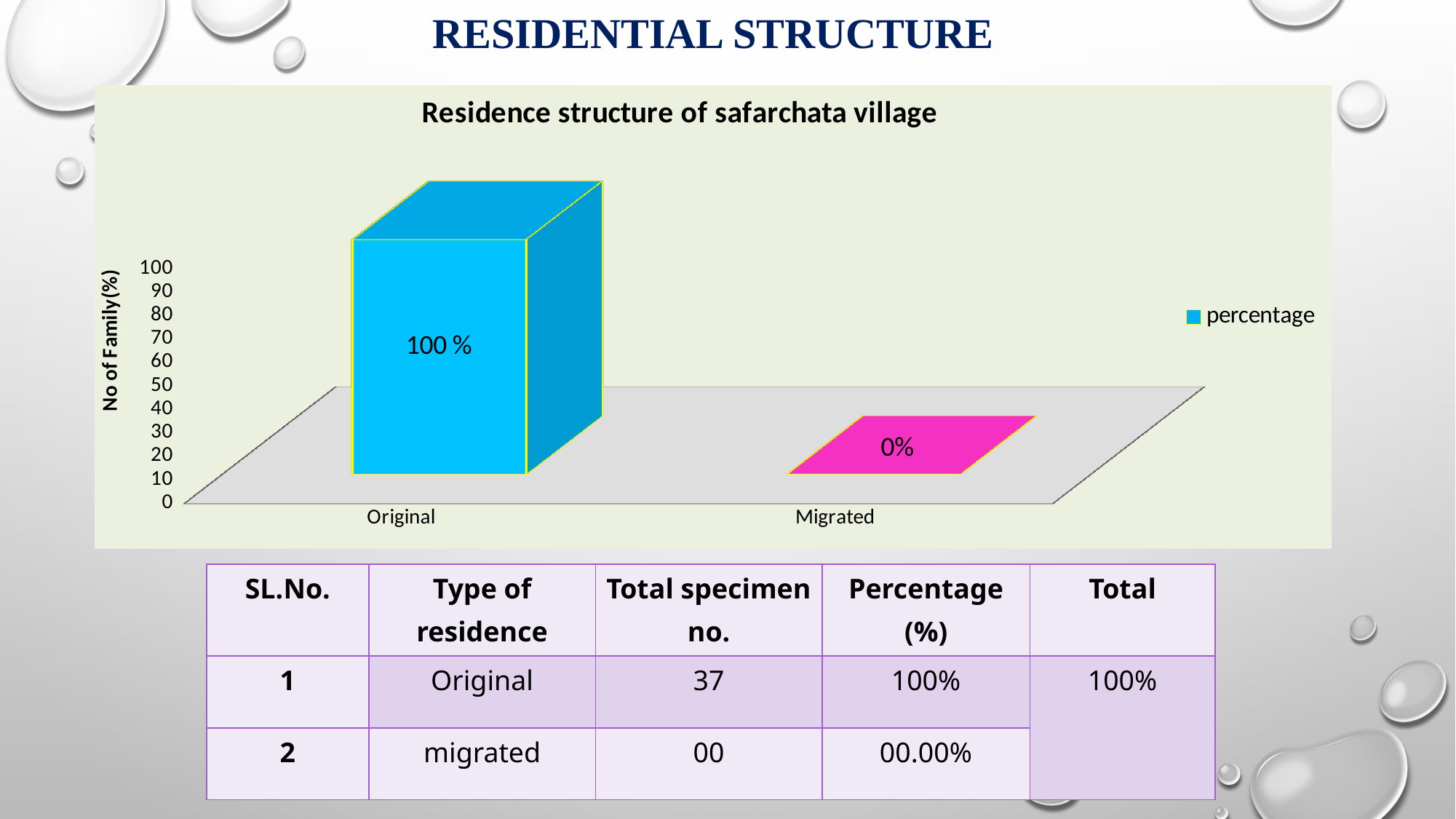
How many series does the legend list? 1 How many categories are shown on the x axis? 2 What type of chart is shown on the slide? bar chart What is the value shown for Original? 100 % Is the value for Original greater or less than 50? greater What is the difference between the values for Original and Migrated? 100 What is the value shown for Migrated? 0% Which category has the lowest value? Migrated Which is larger, the value for Original or the value for Migrated? Original What is the title of the chart? Residence structure of safarchata village What is the label of the y axis? No of Family(%) Which category has the highest value? Original